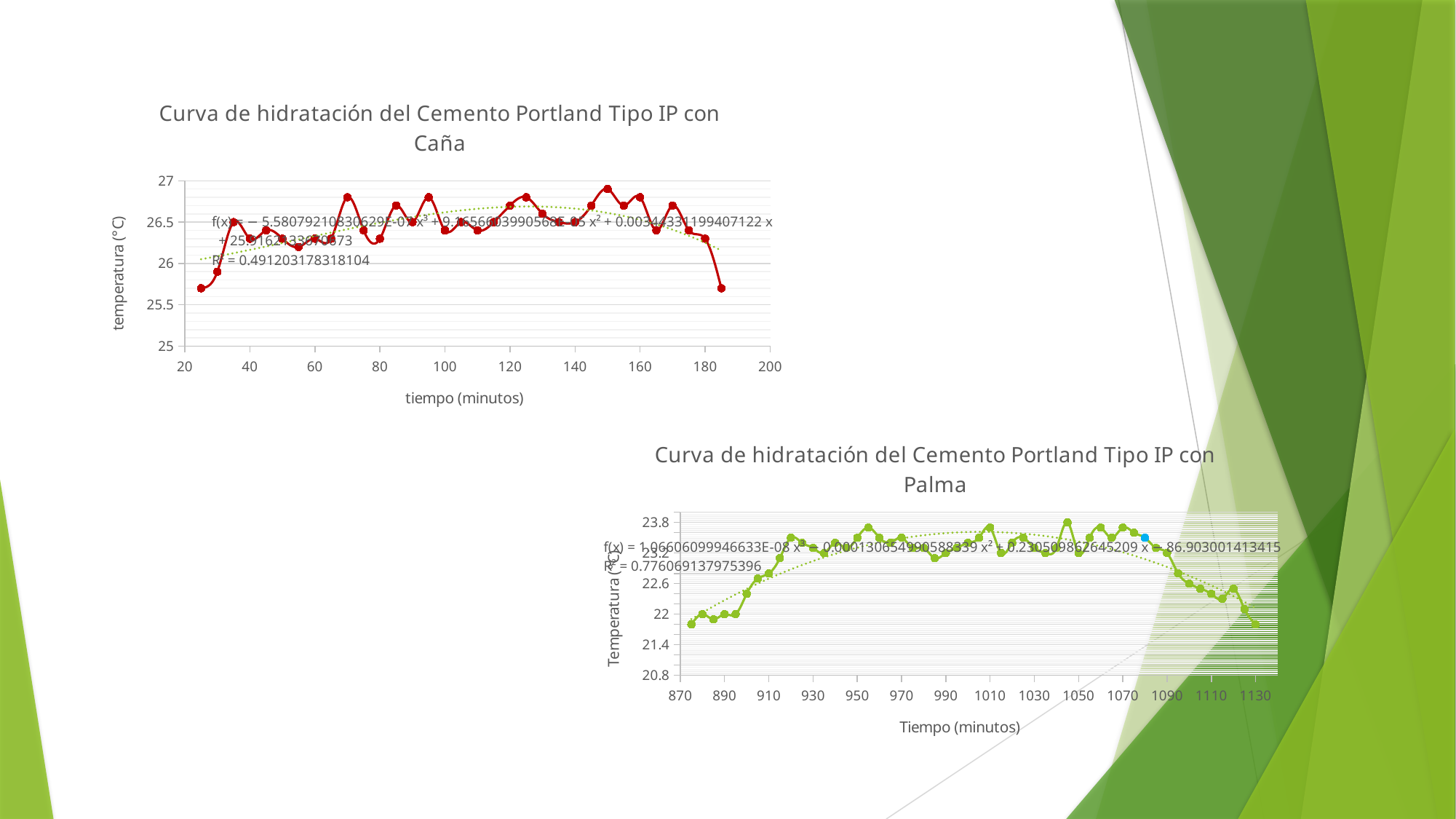
What R² value is printed on the bottom chart (Palma)? 0.776069137975396 In the bottom chart (Palma), is the temperature at 1045 minutes greater or less than 23.2? greater What is the x-axis label of the top chart (Caña)? tiempo (minutos) In the top chart (Caña), does the temperature rise or fall between 175 and 185 minutes? fall In the top chart (Caña), is the temperature at 25 minutes greater or less than 26? less In the bottom chart (Palma), which is higher: the temperature at 875 minutes or at 1045 minutes? 1045 minutes In the top chart (Caña), is the temperature at 185 minutes greater or less than 26? less What kind of chart is the top chart titled 'Curva de hidratación del Cemento Portland Tipo IP con Caña'? line chart In the bottom chart (Palma), does the temperature rise or fall between 875 and 920 minutes? rise In the top chart (Caña), which is higher: the temperature at 25 minutes or at 70 minutes? 70 minutes